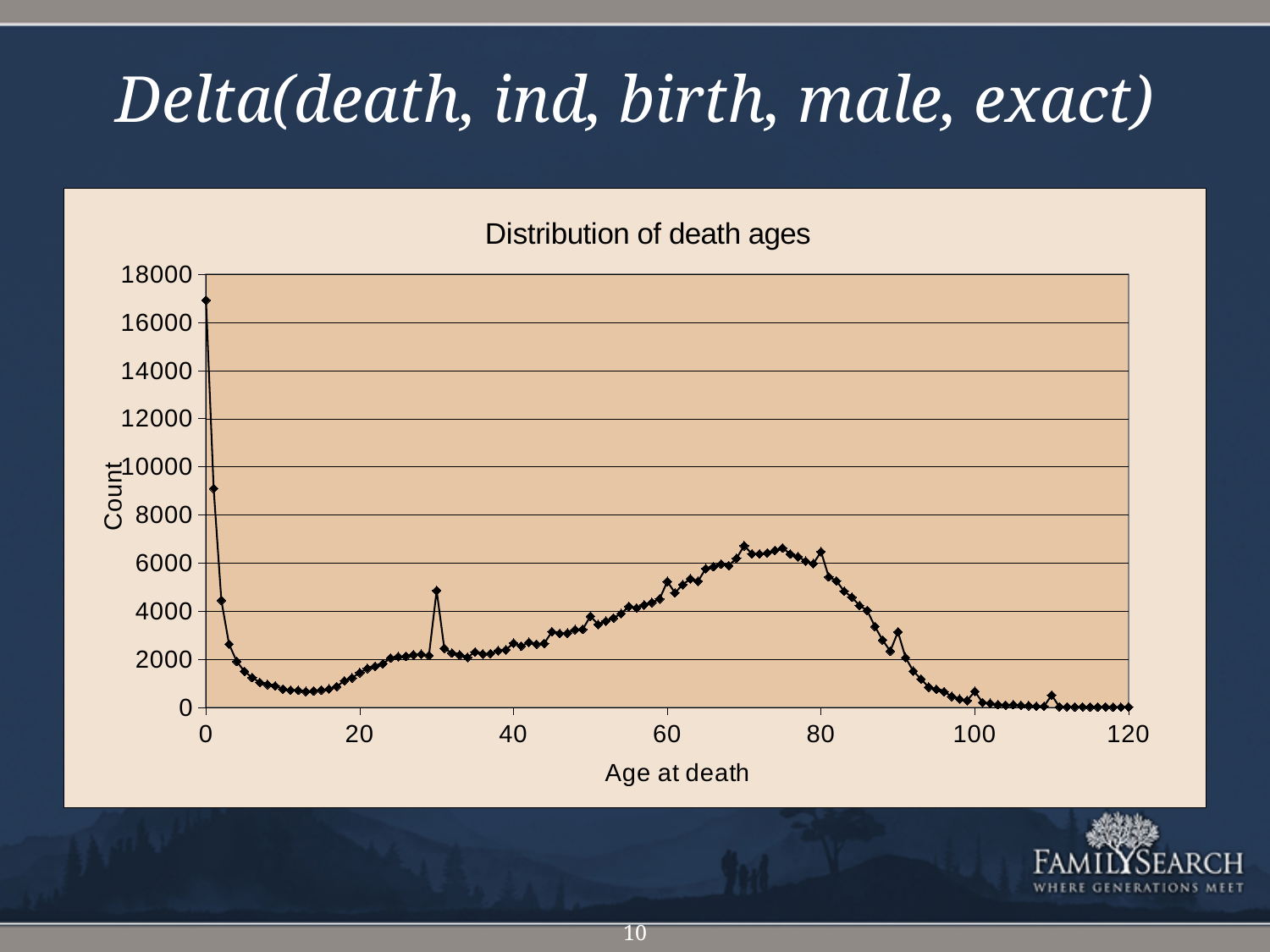
Is the count at age 100 greater or less than 2000? less Does the count rise or fall as age at death goes from 40 to 70? rise Does the count rise or fall as age at death goes from 80 to 100? fall What is the label of the x axis? Age at death At which age at death is the count highest? 0 What kind of chart is shown on the slide? line chart Is the count at age 30 greater or less than 4000? greater Is the count at age 10 greater or less than 2000? less Which has the larger count, age 30 or age 20? age 30 What is the title of the chart? Distribution of death ages